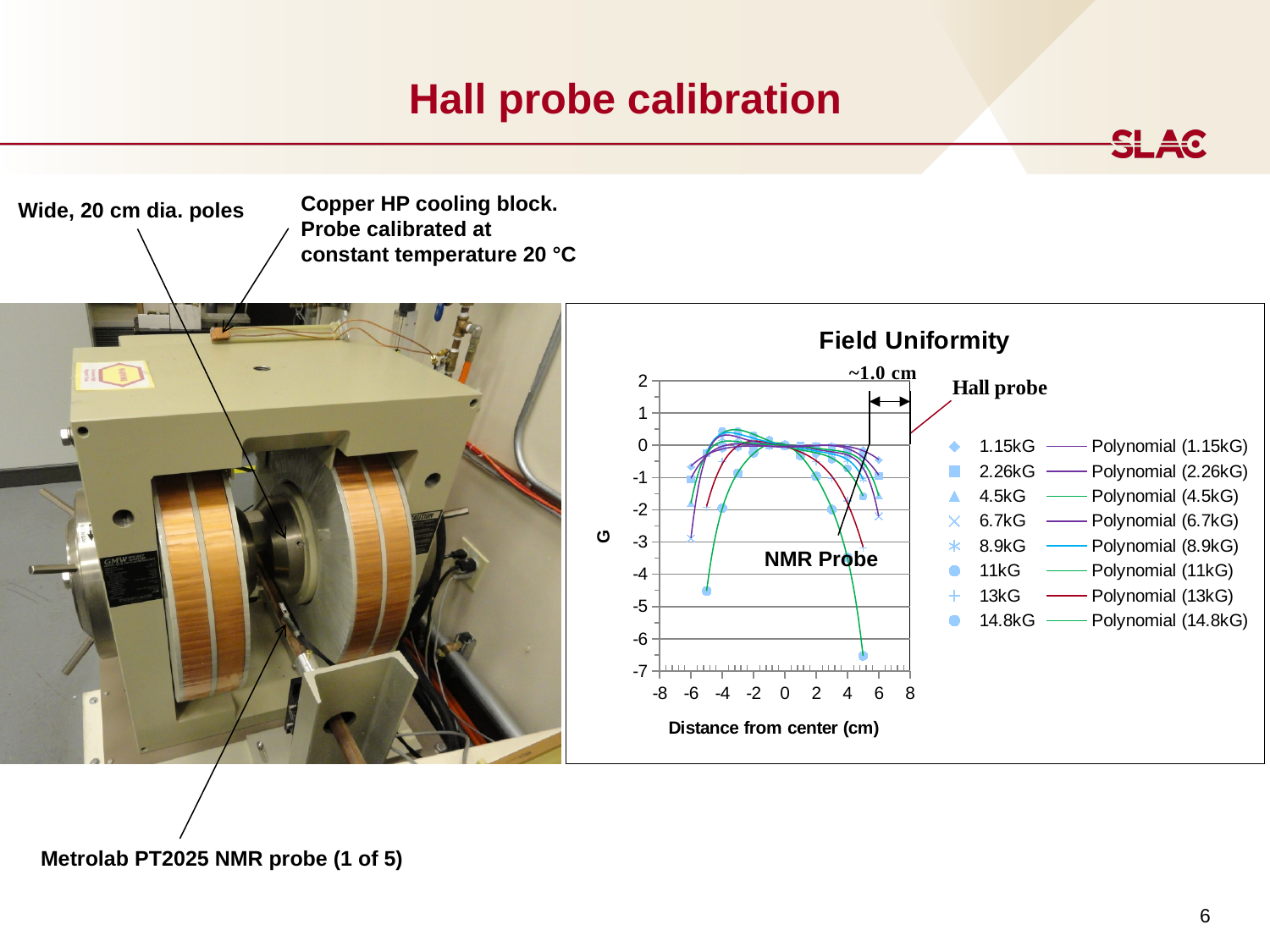
How many field strength values (kG) are listed in the legend of the Field Uniformity chart? 8 What is the x-axis label of the Field Uniformity chart? Distance from center (cm) What is the minimum value shown on the y axis of the Field Uniformity chart? -7 In the Field Uniformity chart, do the plotted values rise or fall as the distance from center increases from 0 cm to 6 cm? fall What is the highest field strength series listed in the legend of the Field Uniformity chart? 14.8kG What is the lowest field strength series listed in the legend of the Field Uniformity chart? 1.15kG What is the title of the chart on the slide? Field Uniformity In the Field Uniformity chart, is the lowest plotted point on the negative side of the x axis (near -5 cm) greater or less than -4? less What kind of chart is the Field Uniformity chart? scatter chart with polynomial trend lines What is the maximum value shown on the x axis of the Field Uniformity chart? 8 In the Field Uniformity chart, is the lowest plotted point greater or less than -6? less How many entries in total does the legend of the Field Uniformity chart list, including the polynomial fits? 16